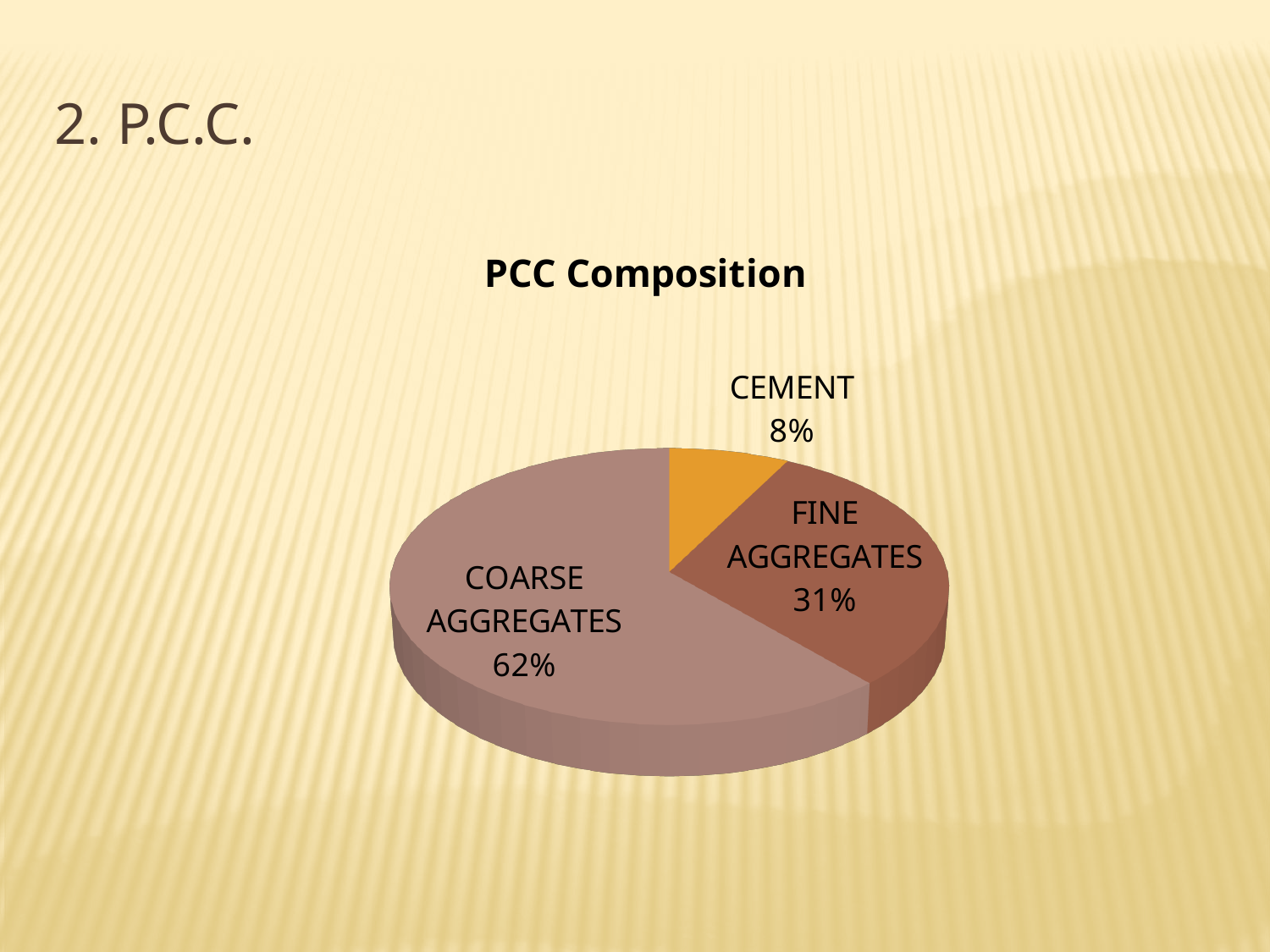
What is the difference in percentage points between COARSE AGGREGATES and FINE AGGREGATES? 31 What is the title of the chart on the slide? PCC Composition Which component has the smallest slice in the PCC Composition chart? CEMENT What colour is the CEMENT slice in the PCC Composition chart? Orange What kind of chart is shown on the slide? Pie chart What is the difference in percentage points between FINE AGGREGATES and CEMENT? 23 How many slices does the PCC Composition pie chart have? 3 What share of the PCC Composition pie is COARSE AGGREGATES? 62% What share of the PCC Composition pie is FINE AGGREGATES? 31% What share of the PCC Composition pie is CEMENT? 8% Which is larger in the PCC Composition chart, FINE AGGREGATES or CEMENT? FINE AGGREGATES Which component has the largest slice in the PCC Composition chart? COARSE AGGREGATES